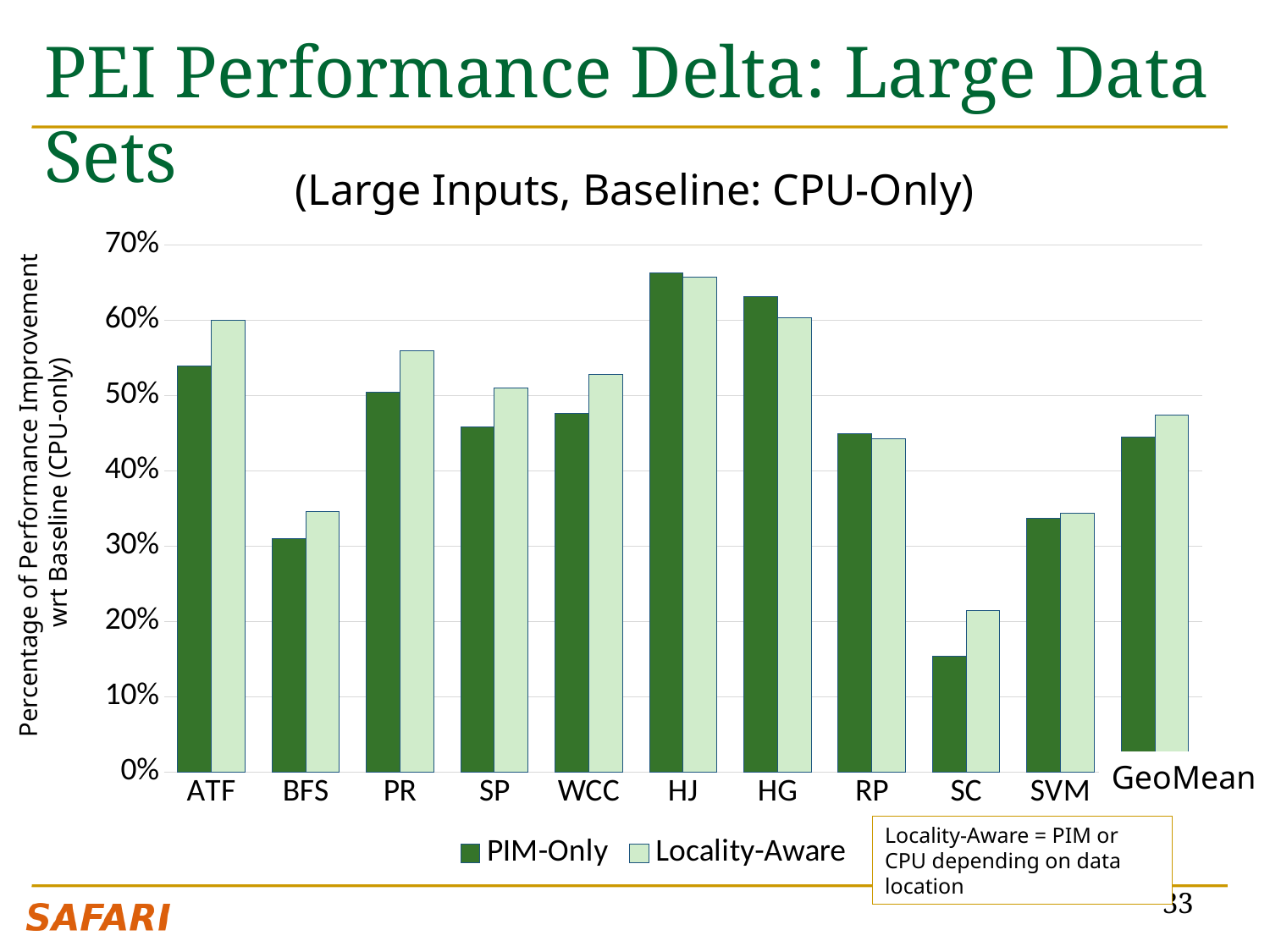
Which category has the lowest PIM-Only value? SC What kind of chart is shown on the slide? Bar chart Is the PIM-Only value for BFS greater or less than 40%? less For ATF, which is larger: PIM-Only or Locality-Aware? Locality-Aware Which category has the highest PIM-Only value? HJ Which category has the lowest Locality-Aware value? SC Is the Locality-Aware value for ATF greater or less than 50%? greater How many categories are shown along the x axis? 11 Is the PIM-Only value for SC greater or less than 20%? less How many series does the legend list? 2 For HG, which is larger: PIM-Only or Locality-Aware? PIM-Only What are the two legend entries of the chart? PIM-Only and Locality-Aware